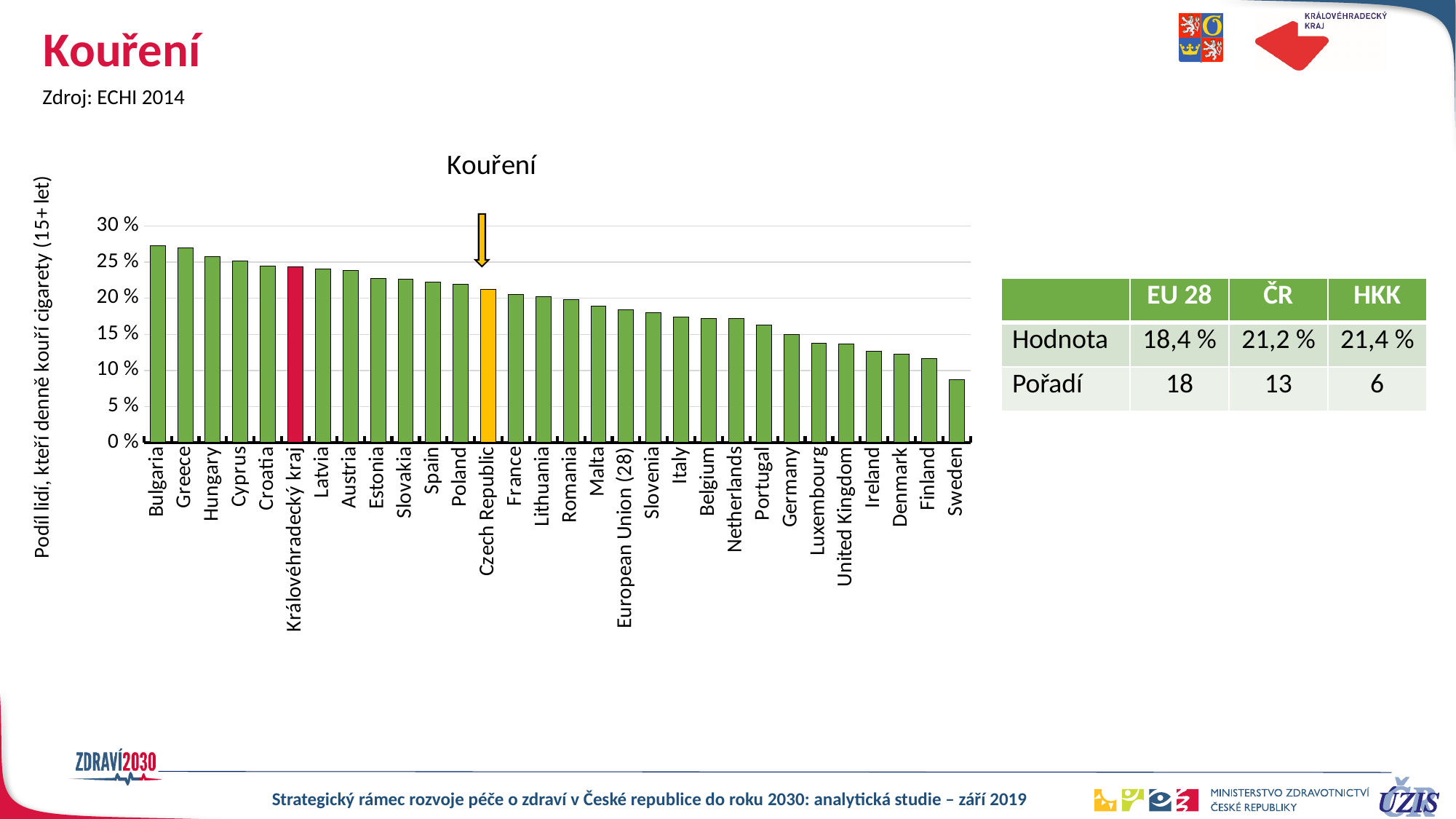
What is the value for European Union (28)? 18,4 % How many categories (bars) are plotted in the chart? 30 What is the value for Czech Republic? 21,2 % What is the difference between the values for Czech Republic and European Union (28)? 2,8 % Do the values rise or fall from left to right along the x axis? fall What kind of chart is shown on the slide? bar chart Which category has the lowest value in the chart? Sweden Is the value for Hungary greater or less than 25 %? greater Which is larger, the value for Latvia or the value for Germany? Latvia What is the title of the chart? Kouření Is the value for Sweden greater or less than 10 %? less